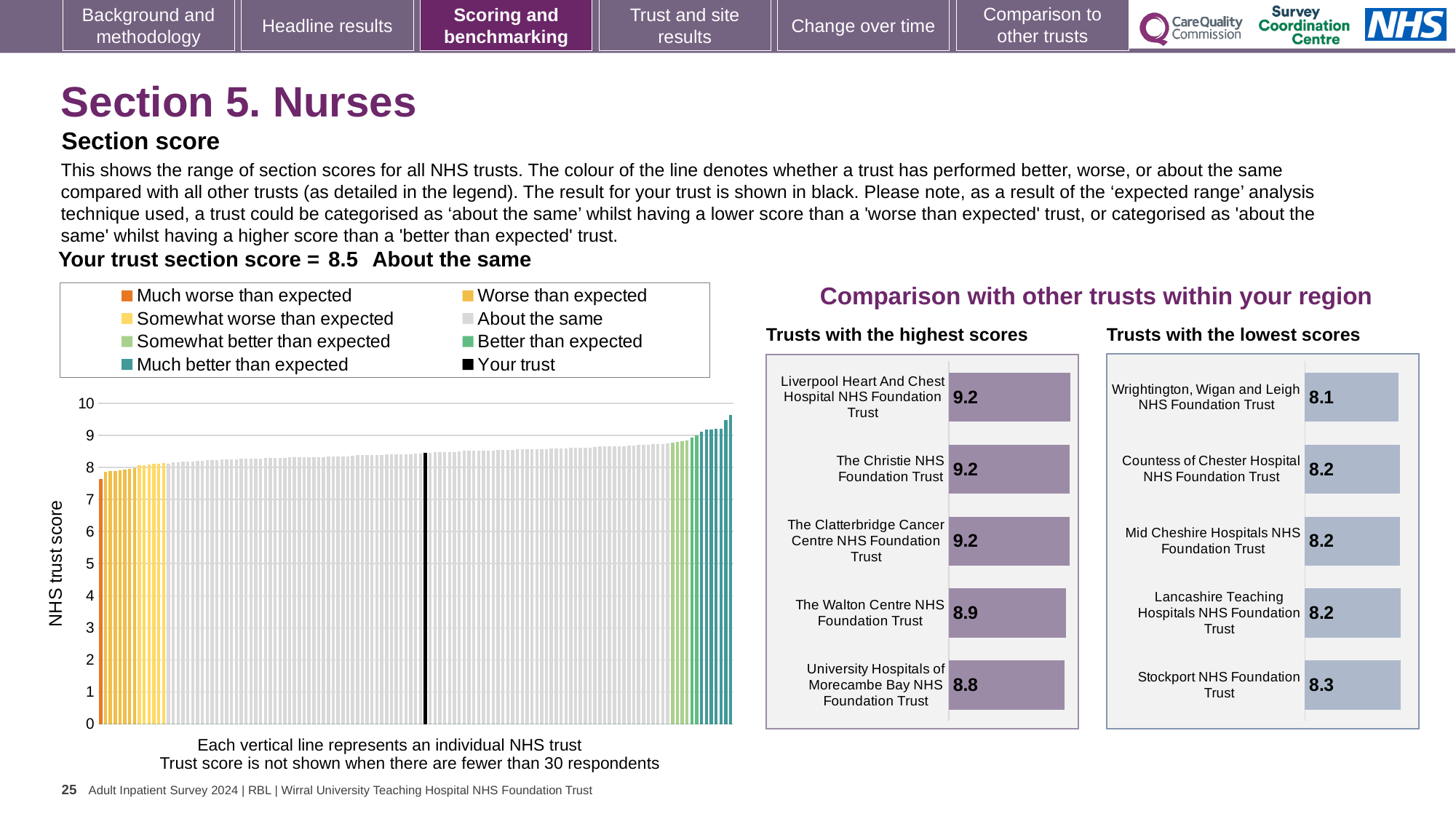
In the 'Trusts with the highest scores' chart, what is the difference between the scores of Liverpool Heart And Chest Hospital NHS Foundation Trust and University Hospitals of Morecambe Bay NHS Foundation Trust? 0.4 In the 'Trusts with the highest scores' chart, which trust has the lowest score? University Hospitals of Morecambe Bay NHS Foundation Trust In the 'Trusts with the highest scores' chart, which has the higher score: The Walton Centre NHS Foundation Trust or University Hospitals of Morecambe Bay NHS Foundation Trust? The Walton Centre NHS Foundation Trust In the large 'NHS trust score' chart, is the value of the leftmost (orange) bar greater or less than 8? less In the 'Trusts with the lowest scores' chart, what is the score for Stockport NHS Foundation Trust? 8.3 In the 'Trusts with the lowest scores' chart, which trust has the lowest score? Wrightington, Wigan and Leigh NHS Foundation Trust How many entries does the legend of the large 'NHS trust score' chart list? 8 In the 'Trusts with the highest scores' chart, what is the score for The Walton Centre NHS Foundation Trust? 8.9 In the 'Trusts with the lowest scores' chart, which trust has the highest score? Stockport NHS Foundation Trust How many trusts are shown in the 'Trusts with the lowest scores' chart? 5 In the 'Trusts with the lowest scores' chart, what is the difference between the scores of Stockport NHS Foundation Trust and Wrightington, Wigan and Leigh NHS Foundation Trust? 0.2 What kind of chart is the large 'NHS trust score' chart on the left of the slide? Bar chart